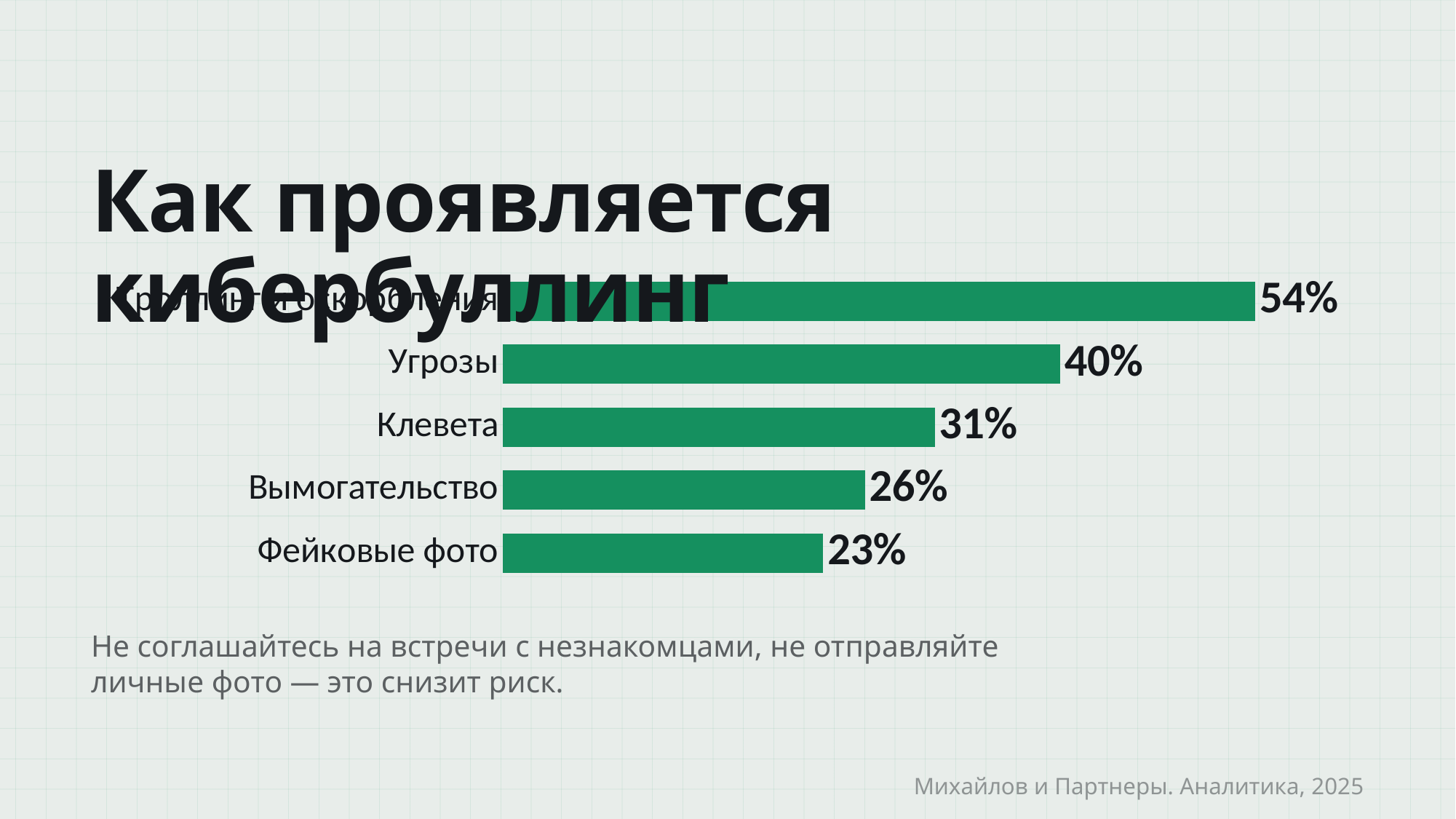
What is the value for Фейковые фото? 23% What colour are the bars on the chart? Green What is the difference between the values for Угрозы and Фейковые фото? 17% What is the largest value shown on the chart? 54% What is the difference between the values for Угрозы and Клевета? 9% What is the value for Угрозы? 40% Which is larger, the value for Вымогательство or the value for Фейковые фото? Вымогательство How many bars are shown on the chart? 5 Which category has the lowest value? Фейковые фото What is the value for Вымогательство? 26% What kind of chart is shown on the slide? Bar chart What is the value for Клевета? 31%